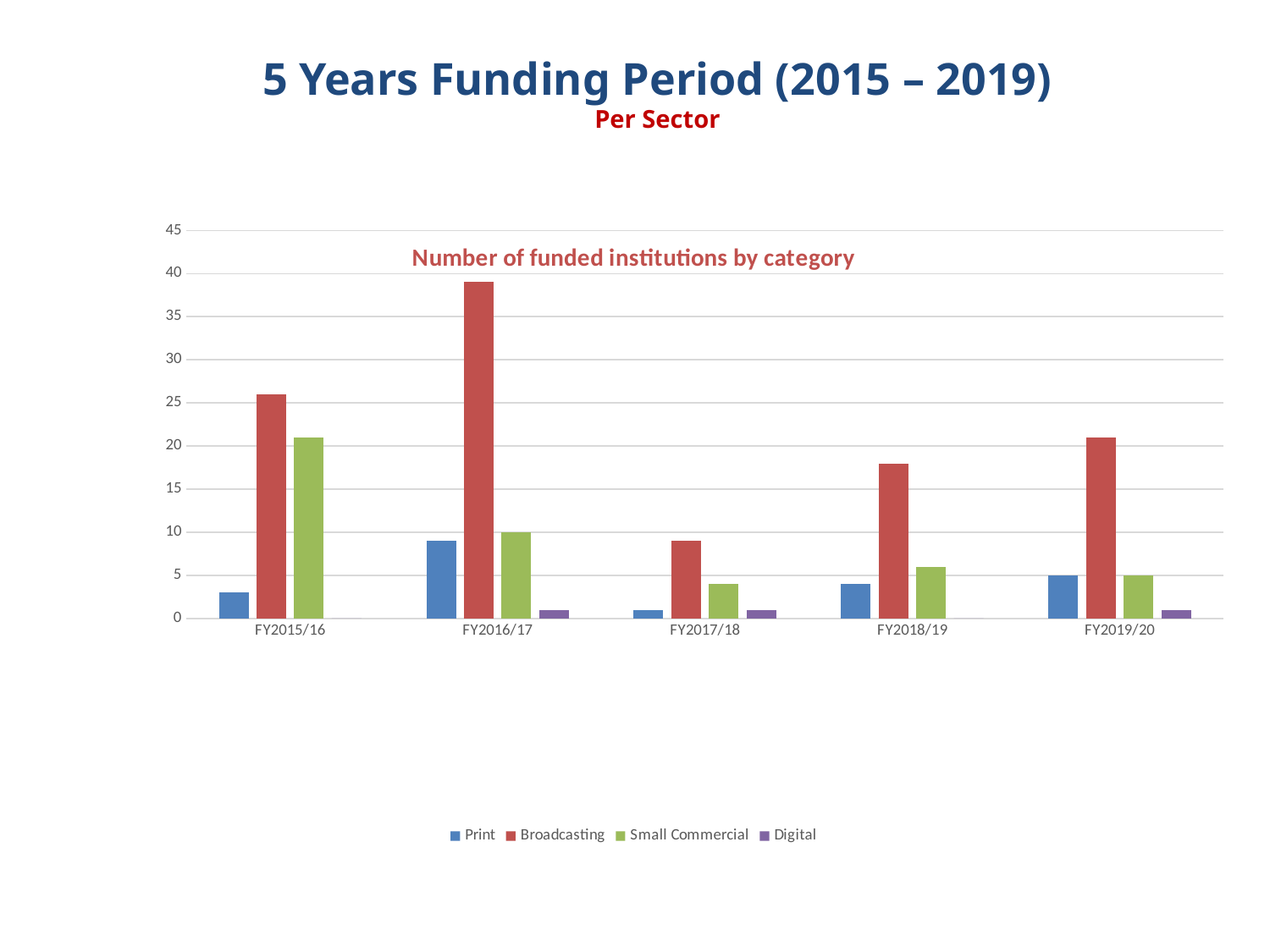
What is the title of the chart? Number of funded institutions by category What kind of chart is shown on the slide? Bar chart In which fiscal year is the Broadcasting bar the highest? FY2016/17 Which fiscal year has the larger Broadcasting value: FY2018/19 or FY2019/20? FY2019/20 In which fiscal year is the Broadcasting bar the lowest? FY2017/18 Is the value for Print in FY2016/17 greater or less than 10? less What colour represents the Broadcasting series in the legend? Red Is the value for Broadcasting in FY2015/16 greater or less than 20? greater Is the value for Broadcasting in FY2016/17 greater or less than 35? greater How many series does the legend list? 4 How many fiscal years are shown on the x axis? 5 In FY2015/16, which is larger: Broadcasting or Small Commercial? Broadcasting